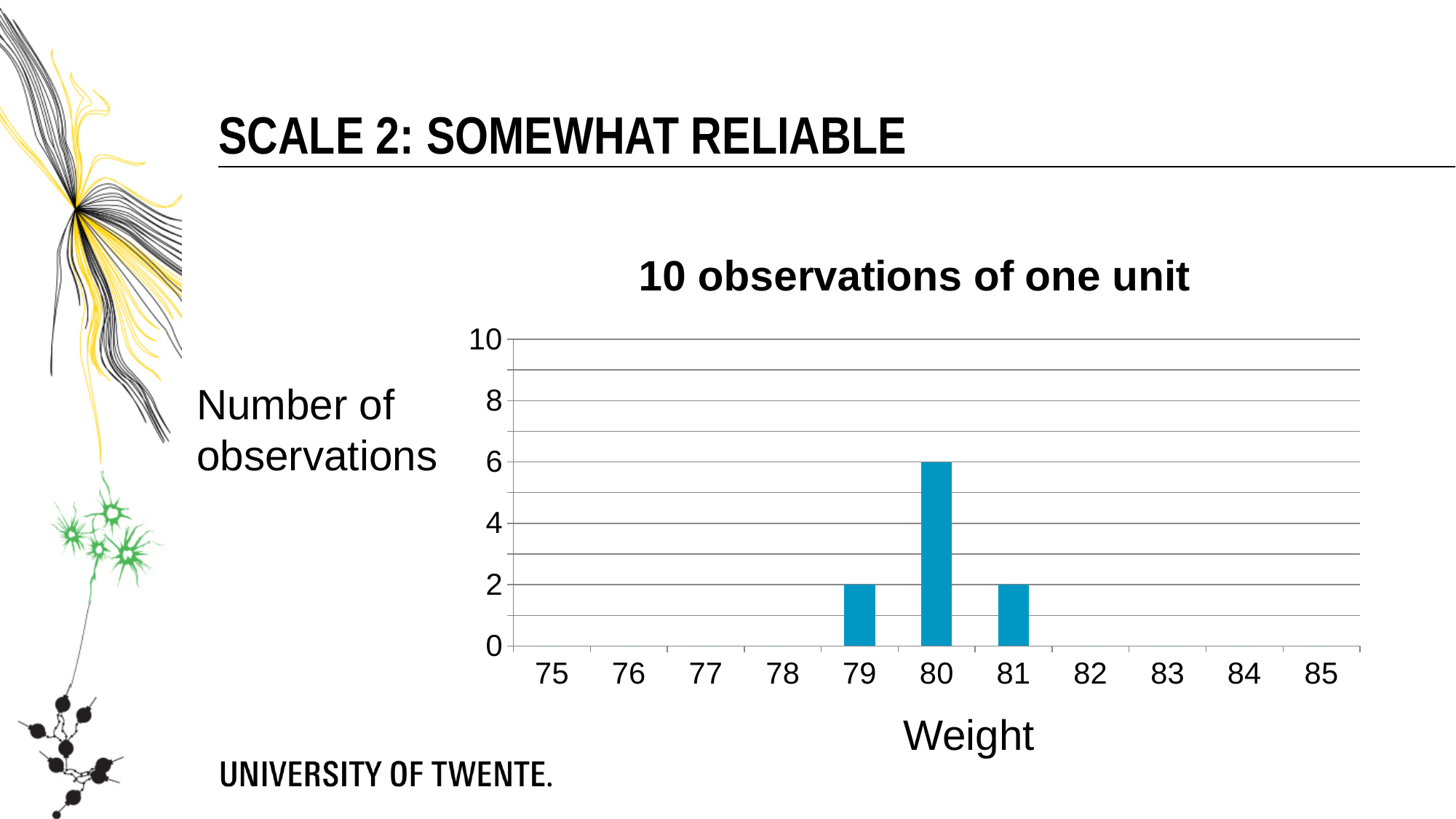
How many weight values are labelled on the x axis? 11 What kind of chart is shown on the slide? bar chart What is the number of observations for weight 79? 2 What is the title of the chart? 10 observations of one unit Is the number of observations for weight 80 greater or less than 4? greater Which weight has the highest number of observations? 80 What is the number of observations for weight 80? 6 How many weight values have a non-zero bar? 3 What is the label of the x axis? Weight What is the difference between the number of observations at weight 80 and at weight 79? 4 What is the number of observations for weight 81? 2 Which has more observations, weight 80 or weight 81? 80